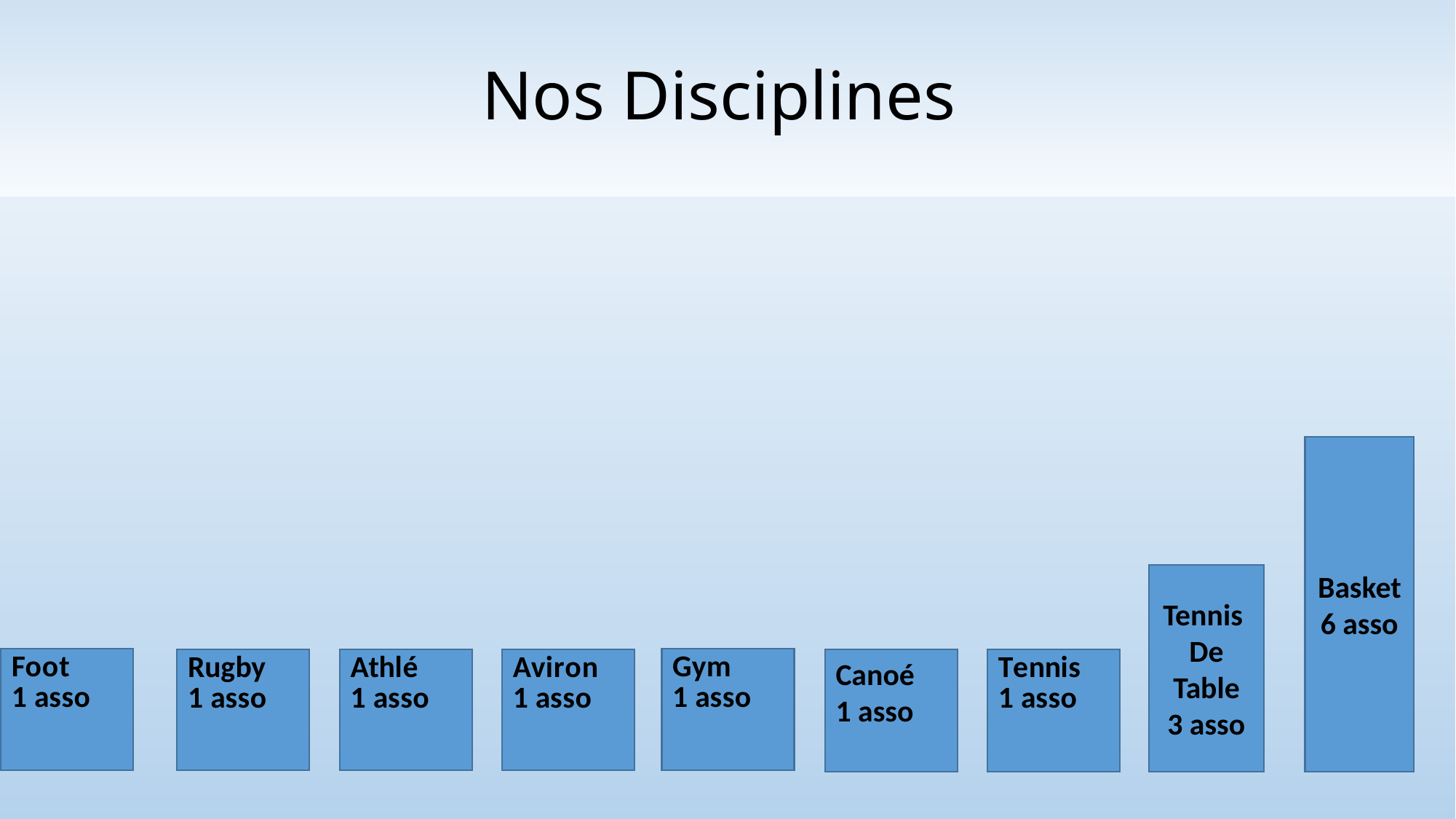
What is the value shown for Tennis De Table? 3 asso How many disciplines have a value of 1 asso? 7 How many disciplines are shown on the chart? 9 What is the value shown for Rugby? 1 asso What kind of chart is shown on the slide? Bar chart What is the title of the slide? Nos Disciplines What is the value shown for Basket? 6 asso What is the difference between the values for Basket and Tennis De Table? 3 asso Which is larger, the value for Basket or the value for Tennis De Table? Basket Which is larger, the value for Tennis De Table or the value for Canoé? Tennis De Table What is the difference between the values for Tennis De Table and Tennis? 2 asso Which discipline has the highest value? Basket